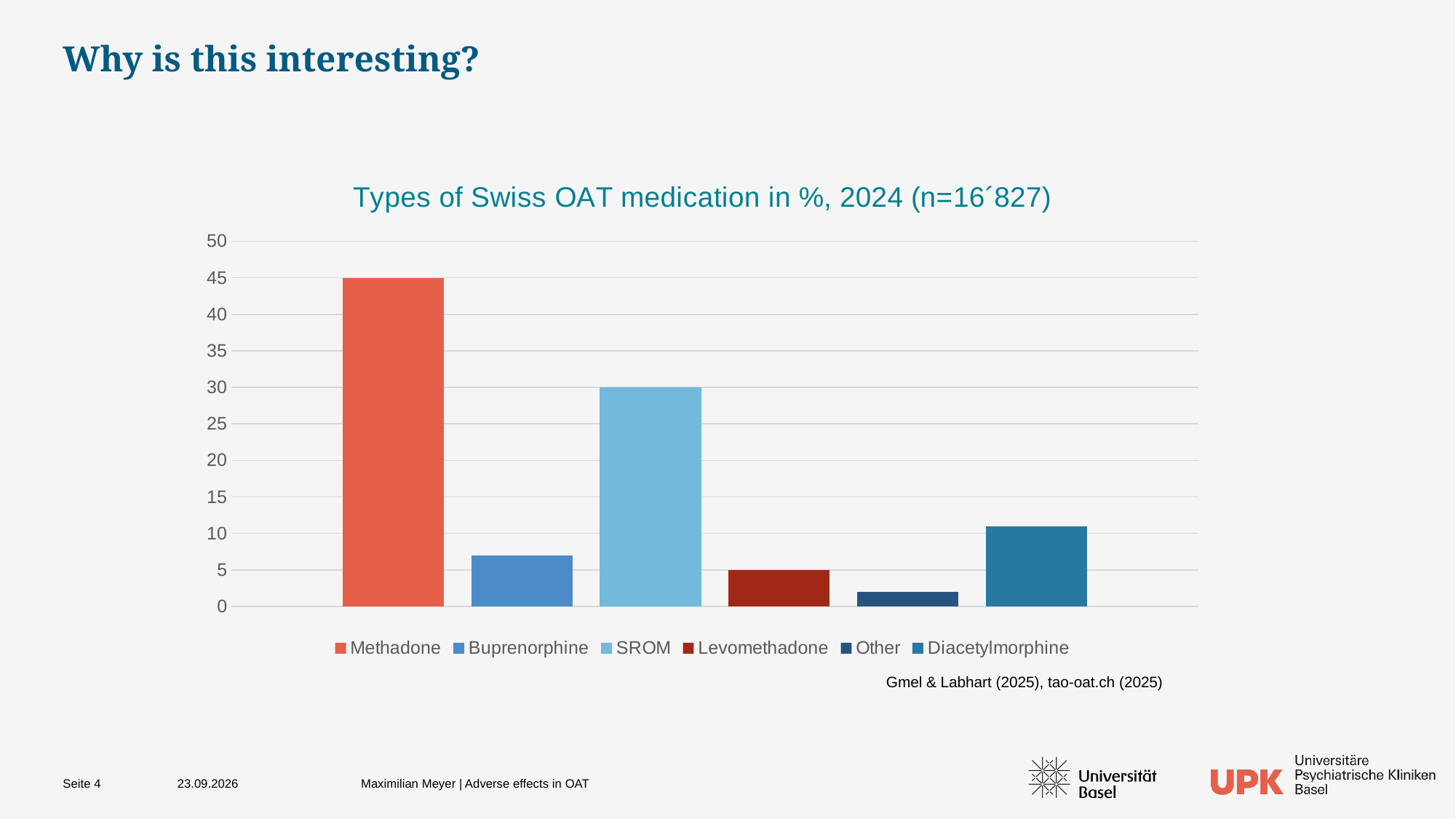
What is the title of the chart? Types of Swiss OAT medication in %, 2024 (n=16´827) What is the value for Levomethadone? 5 Which medication type has the highest value? Methadone Is the value for Buprenorphine greater or less than 10? less Which is larger, the value for Buprenorphine or the value for Diacetylmorphine? Diacetylmorphine Which medication type has the lowest value? Other How many medication types (bars) are shown in the chart? 6 What is the value for SROM? 30 What type of chart is shown on the slide? Bar chart How many entries does the legend list? 6 What is the difference between the values for Methadone and SROM? 15 What is the value for Methadone? 45